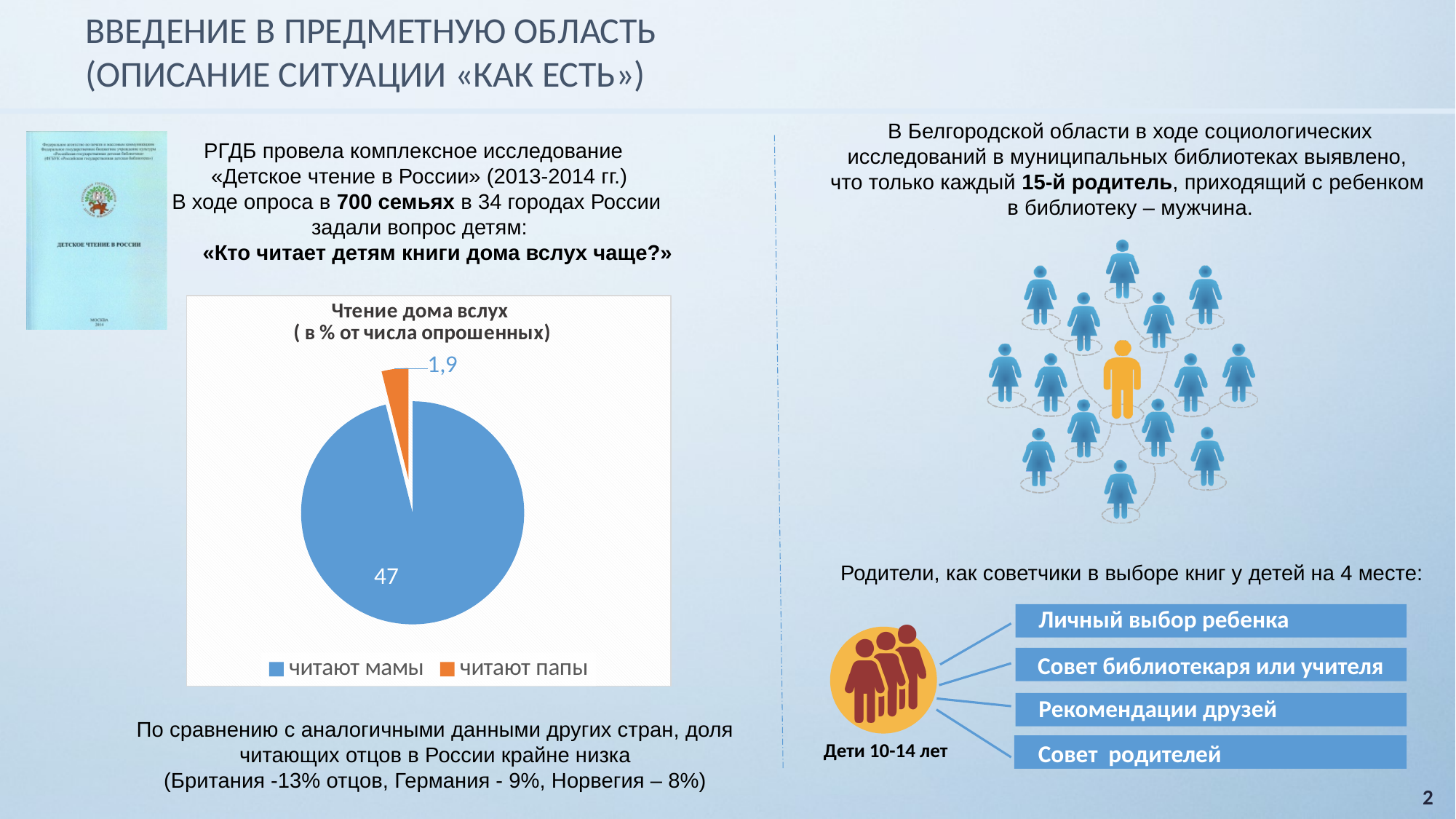
Which category has the largest slice in the pie chart «Чтение дома вслух»? читают мамы What is the title of the chart on the slide? Чтение дома вслух ( в % от числа опрошенных) What colour is the «читают папы» slice in the pie chart? Orange How many slices does the pie chart «Чтение дома вслух» have? 2 What value is shown for «читают мамы» in the pie chart «Чтение дома вслух»? 47 What kind of chart is shown on the slide? Pie chart What value is shown for «читают папы» in the pie chart «Чтение дома вслух»? 1,9 What is the difference between the values for «читают мамы» and «читают папы» in the pie chart «Чтение дома вслух»? 45,1 How many entries does the legend of the pie chart «Чтение дома вслух» list? 2 Which category has the smallest slice in the pie chart «Чтение дома вслух»? читают папы In the pie chart «Чтение дома вслух», which is larger: «читают мамы» or «читают папы»? читают мамы